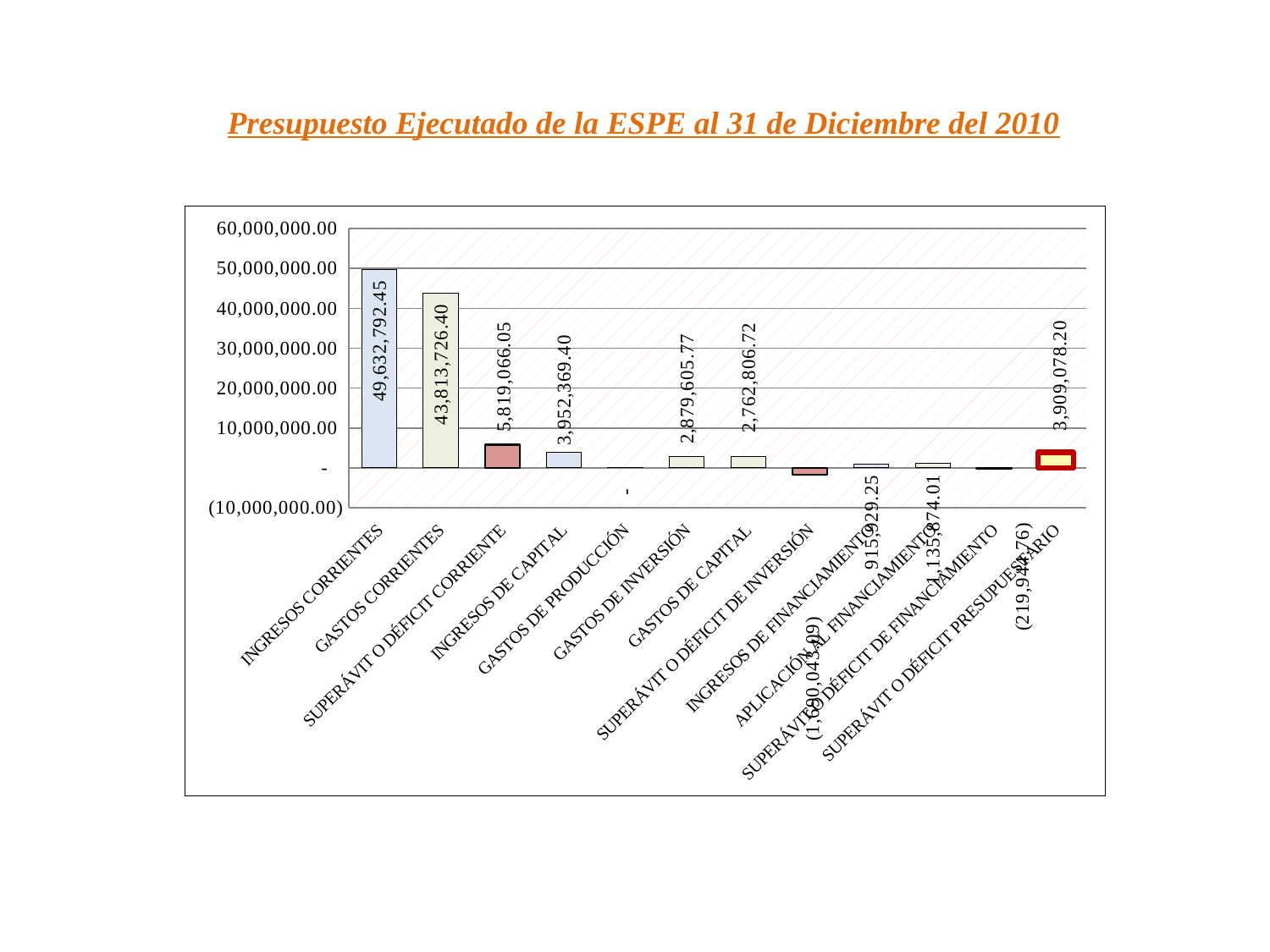
What kind of chart is shown on the slide? bar chart What is the value for SUPERÁVIT O DÉFICIT PRESUPUESTARIO? 3,909,078.20 What is the value for INGRESOS DE CAPITAL? 3,952,369.40 What is the value for INGRESOS CORRIENTES? 49,632,792.45 Which is larger, GASTOS DE INVERSIÓN or GASTOS DE CAPITAL? GASTOS DE INVERSIÓN What is the value for SUPERÁVIT O DÉFICIT CORRIENTE? 5,819,066.05 How many categories are shown on the x axis? 12 Is the value for GASTOS CORRIENTES greater or less than 40,000,000.00? greater Which category has the highest value? INGRESOS CORRIENTES What is the value for GASTOS CORRIENTES? 43,813,726.40 What is the value for GASTOS DE INVERSIÓN? 2,879,605.77 What is the difference between INGRESOS CORRIENTES and GASTOS CORRIENTES? 5,819,066.05